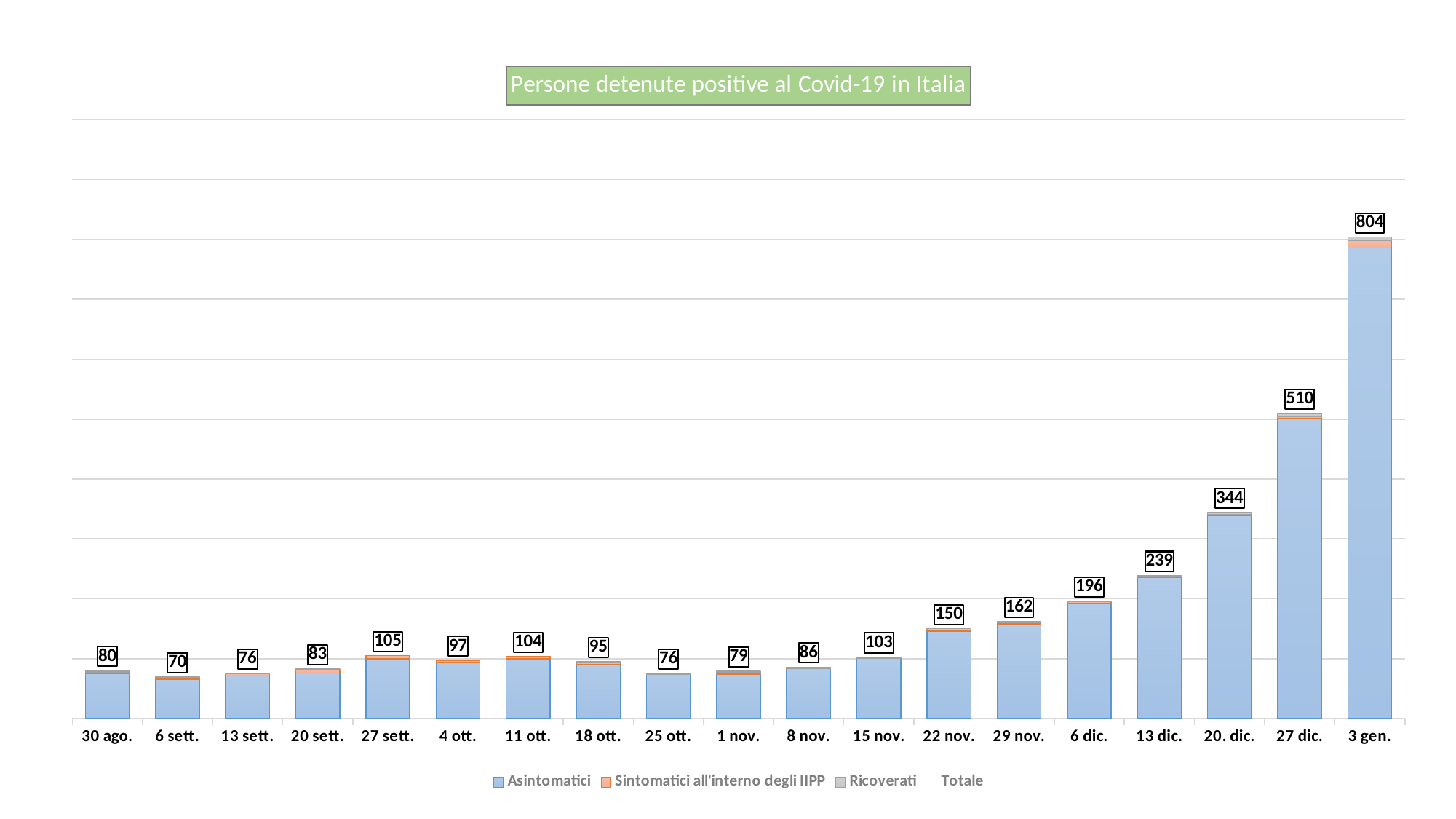
What is the title of the chart? Persone detenute positive al Covid-19 in Italia Which date has the lowest total? 6 sett. Which has a larger total, 29 nov. or 6 dic.? 6 dic. How many series does the legend list? 4 How many dates are shown on the x axis? 19 What is the total number of positive detainees shown for 3 gen.? 804 What is the total value labelled for 27 sett.? 105 Which date has the highest total? 3 gen. What kind of chart is this? Stacked bar chart What is the total value labelled for 22 nov.? 150 What is the difference between the totals for 20. dic. and 13 dic.? 105 What is the difference between the totals for 3 gen. and 27 dic.? 294